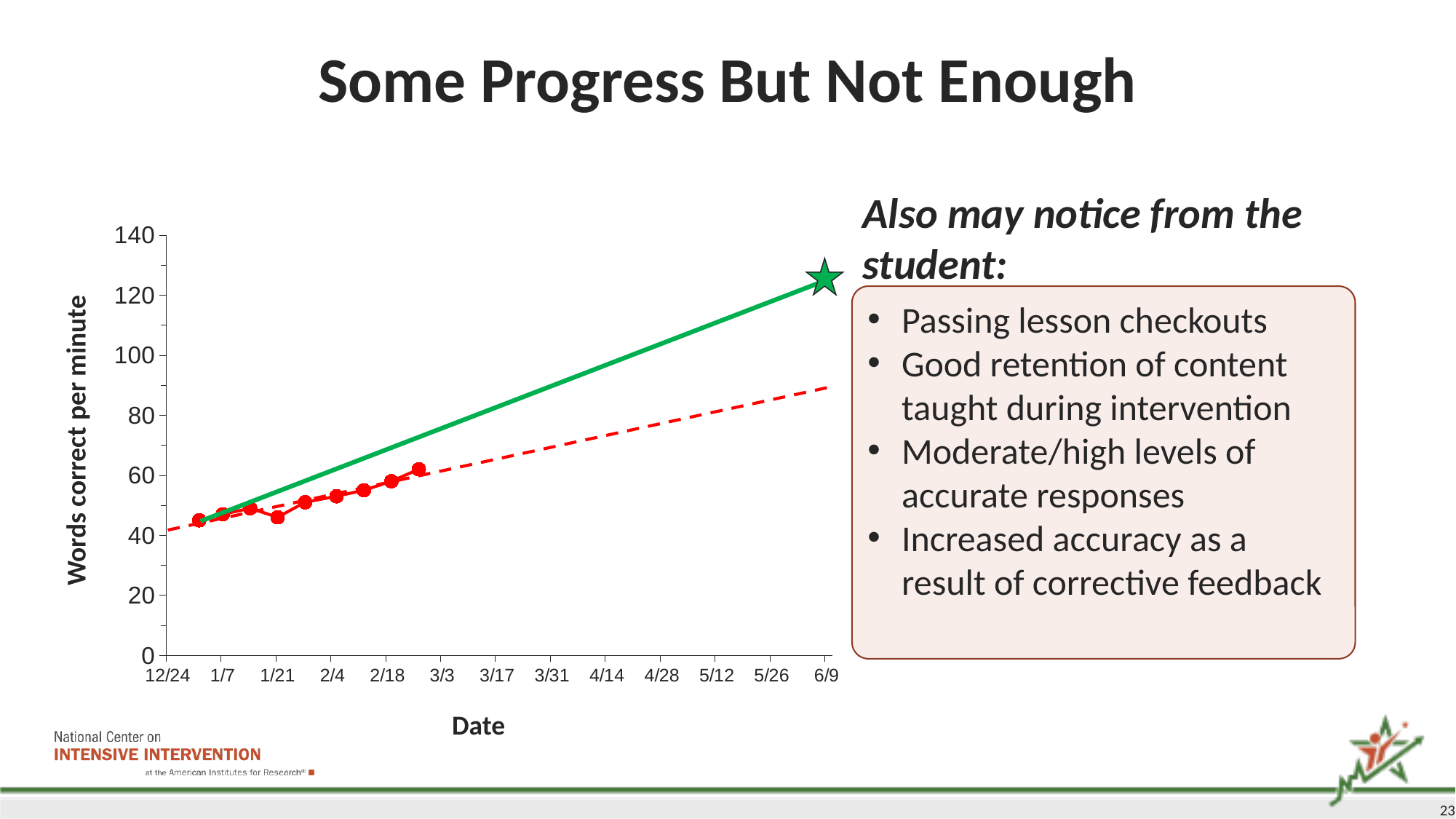
What kind of chart is shown on the slide? line chart Is the value of the red data point at 1/21 greater or less than 60? less Is the value of the red dashed trend line at 6/9 greater or less than 100? less What is the label of the y axis? Words correct per minute How many red data points are plotted on the chart? 9 Do the plotted red data points generally rise or fall along the x axis? rise Is the value of the last red data point (around 2/25) greater or less than 80? less What is the highest value shown on the y axis? 140